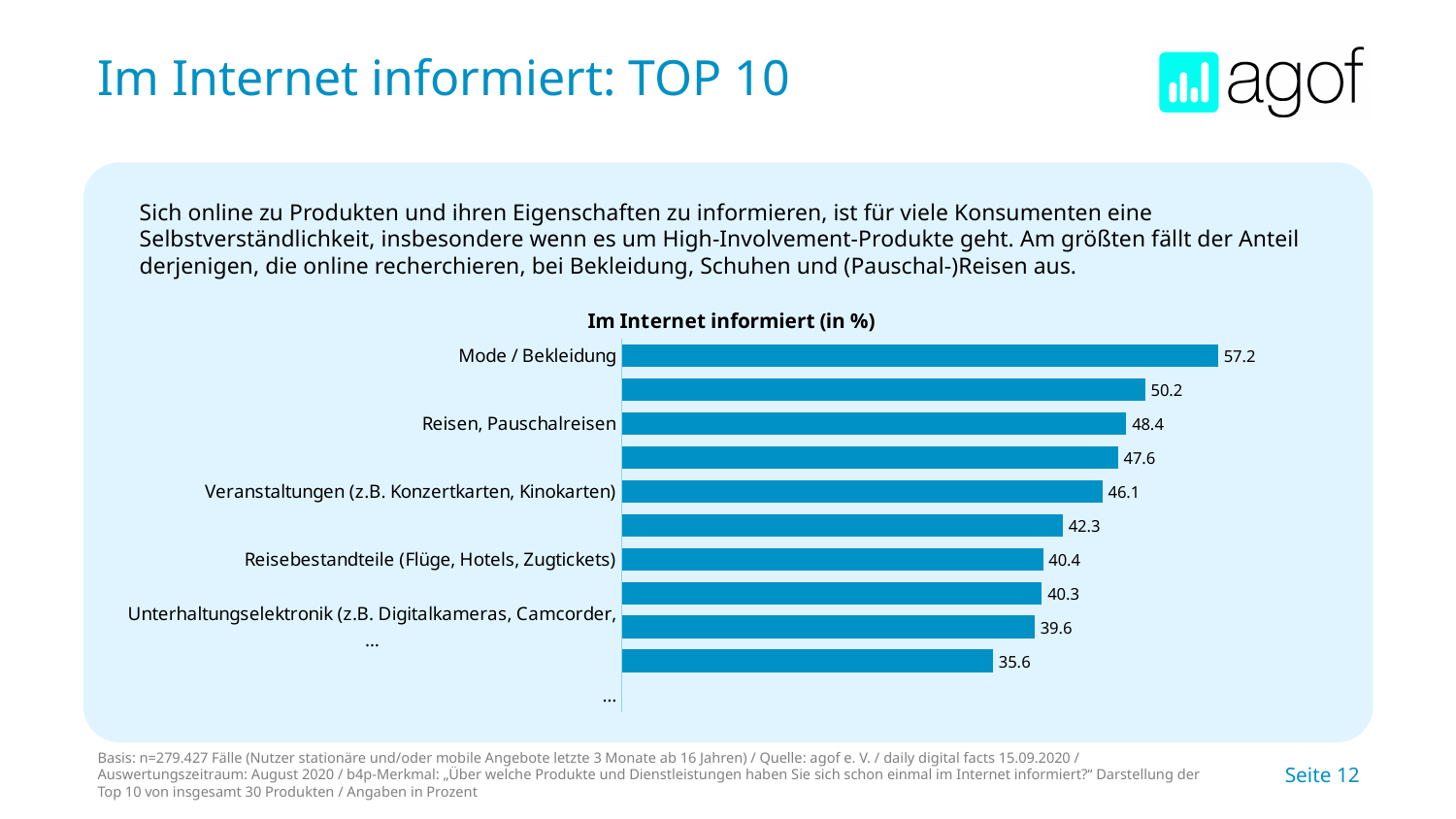
Which is larger, the value for Veranstaltungen (z.B. Konzertkarten, Kinokarten) or the value for Reisebestandteile (Flüge, Hotels, Zugtickets)? Veranstaltungen (z.B. Konzertkarten, Kinokarten) What is the lowest value shown on the chart? 35.6 What is the value for Mode / Bekleidung? 57.2 What is the value for Reisebestandteile (Flüge, Hotels, Zugtickets)? 40.4 What is the value for Reisen, Pauschalreisen? 48.4 Do the values rise or fall going from the top bar to the bottom bar? Fall What kind of chart is shown on the slide? Bar chart What is the title of the chart? Im Internet informiert (in %) What is the difference between the values for Mode / Bekleidung and Reisen, Pauschalreisen? 8.8 How many bars are plotted on the chart? 10 Which category has the highest value? Mode / Bekleidung What is the value for Veranstaltungen (z.B. Konzertkarten, Kinokarten)? 46.1